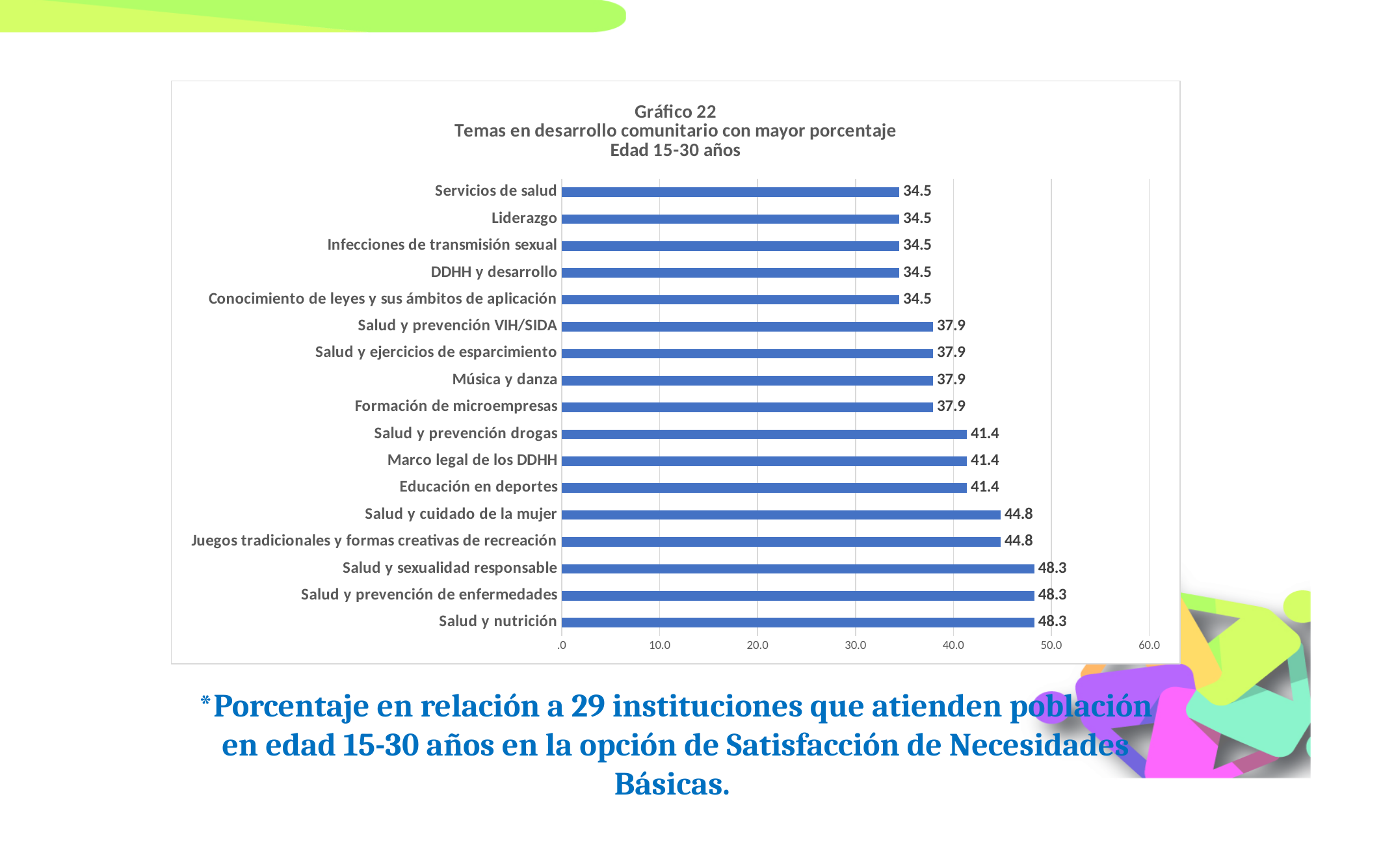
What is the lowest value shown in the chart? 34.5 What is the value for Salud y nutrición? 48.3 What is the value for Salud y cuidado de la mujer? 44.8 What is the value for Liderazgo? 34.5 What is the value for Música y danza? 37.9 Which has a larger value, Educación en deportes or Formación de microempresas? Educación en deportes What is the highest value shown in the chart? 48.3 How many categories are shown in the chart? 17 What type of chart is shown on the slide? bar chart What is the value for Salud y prevención drogas? 41.4 What age range is named in the chart title? 15-30 años What is the difference between the values for Salud y sexualidad responsable and Servicios de salud? 13.8